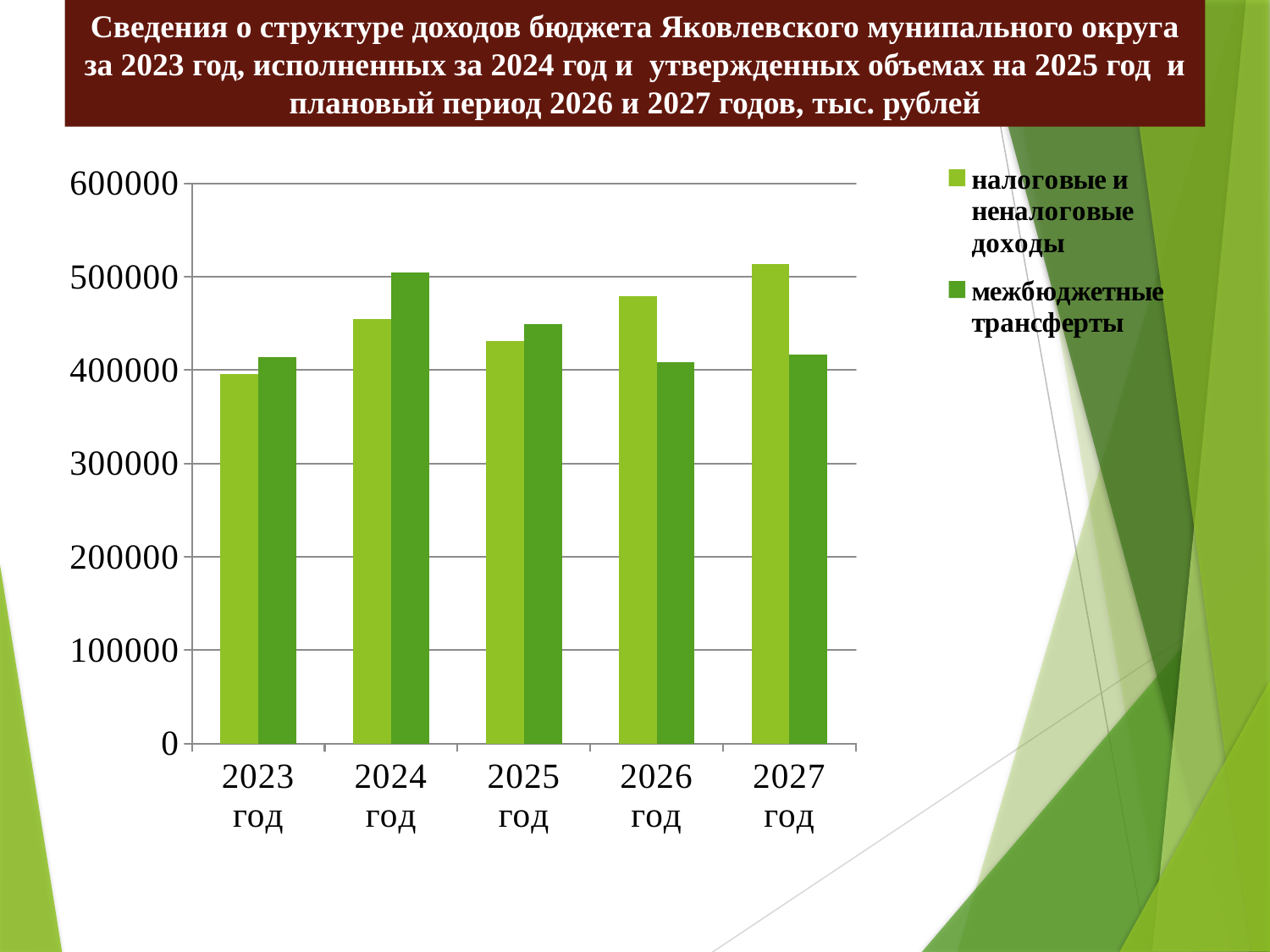
In which year are налоговые и неналоговые доходы the highest? 2027 год From 2025 год to 2027 год, do налоговые и неналоговые доходы rise or fall? rise How many years are shown on the x axis? 5 How many series does the legend list? 2 Is the value for межбюджетные трансферты in 2025 год greater or less than 400000? greater Is the value for налоговые и неналоговые доходы in 2027 год greater or less than 500000? greater Is the value for налоговые и неналоговые доходы in 2024 год greater or less than 500000? less What kind of chart is shown on the slide? Bar chart In 2026 год, which is larger: налоговые и неналоговые доходы or межбюджетные трансферты? налоговые и неналоговые доходы In 2024 год, which is larger: налоговые и неналоговые доходы or межбюджетные трансферты? межбюджетные трансферты In which year are налоговые и неналоговые доходы the lowest? 2023 год In which year are межбюджетные трансферты the highest? 2024 год